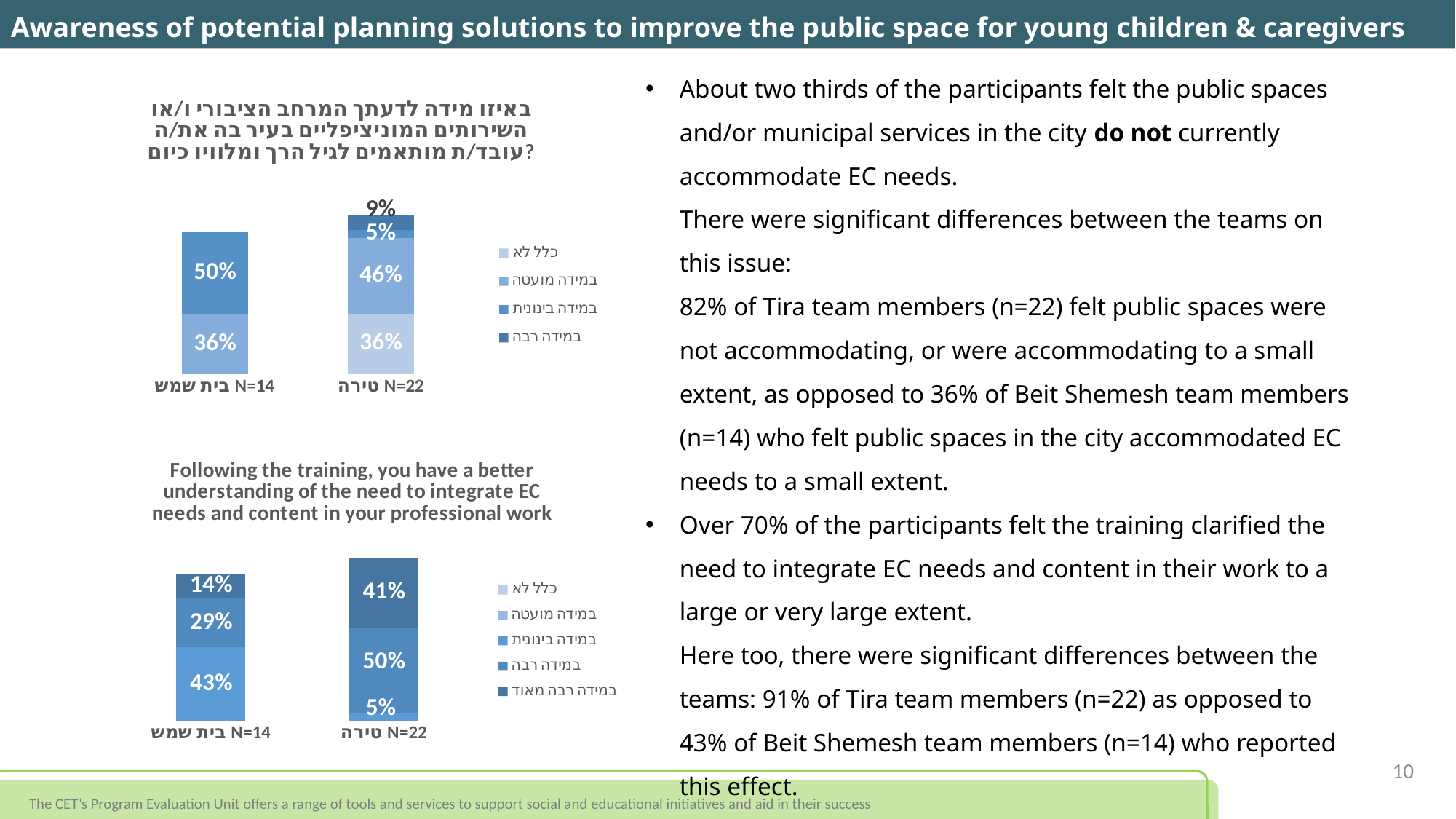
In the bottom chart, what is the value of the topmost segment of the טירה N=22 bar? 41% In the top chart, how many categories (bars) are shown? 2 In the bottom chart, what is the value of the bottom segment of the בית שמש N=14 bar? 43% What kind of chart is the top chart on the slide? stacked bar chart In the bottom chart, what is the difference between the 50% segment and the 5% segment of the טירה N=22 bar? 45% In the bottom chart, which bar has the larger topmost segment, בית שמש N=14 or טירה N=22? טירה N=22 In the top chart, what is the value of the bottom segment of the בית שמש N=14 bar? 36% In the top chart, how many series does the legend list? 4 In the top chart, what is the value of the topmost segment of the טירה N=22 bar? 9% In the top chart, what is the total of the labelled segments in the בית שמש N=14 bar? 86% In the bottom chart titled 'Following the training, you have a better understanding of the need to integrate EC needs and content in your professional work', how many series does the legend list? 5 In the top chart, what is the value of the largest segment of the טירה N=22 bar? 46%